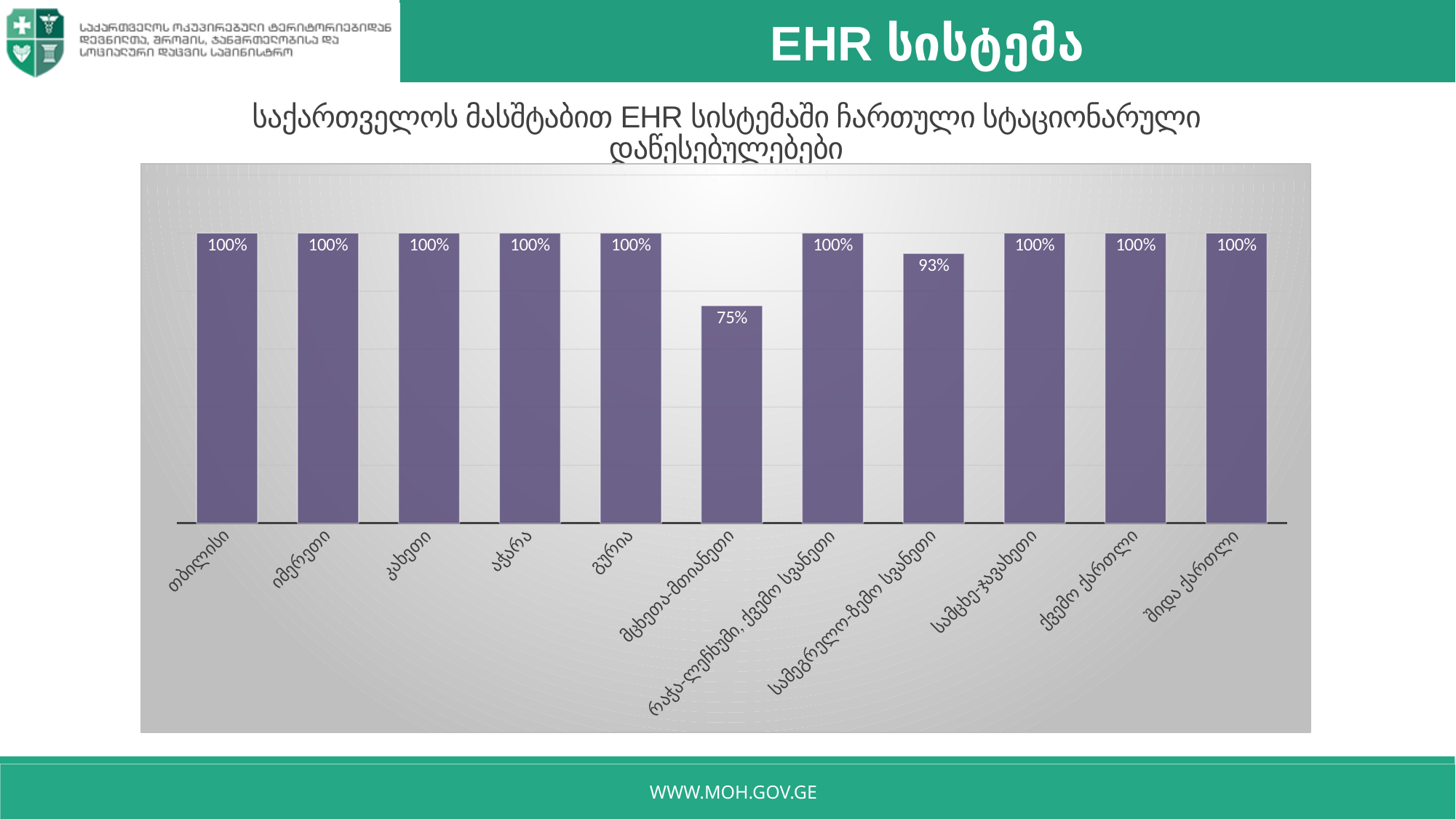
What is the value for აჭარა? 100% Which category has the lowest value? მცხეთა-მთიანეთი How many categories have a value of 100%? 9 Which is larger, the value for გურია or the value for სამეგრელო-ზემო სვანეთი? გურია What is the difference between the values for სამეგრელო-ზემო სვანეთი and მცხეთა-მთიანეთი? 18% How many categories are shown on the chart? 11 Which is larger, the value for სამეგრელო-ზემო სვანეთი or the value for მცხეთა-მთიანეთი? სამეგრელო-ზემო სვანეთი What is the value for სამეგრელო-ზემო სვანეთი? 93% What is the value for თბილისი? 100% What is the value for მცხეთა-მთიანეთი? 75% What is the difference between the values for თბილისი and მცხეთა-მთიანეთი? 25% What kind of chart is shown on the slide? Bar chart